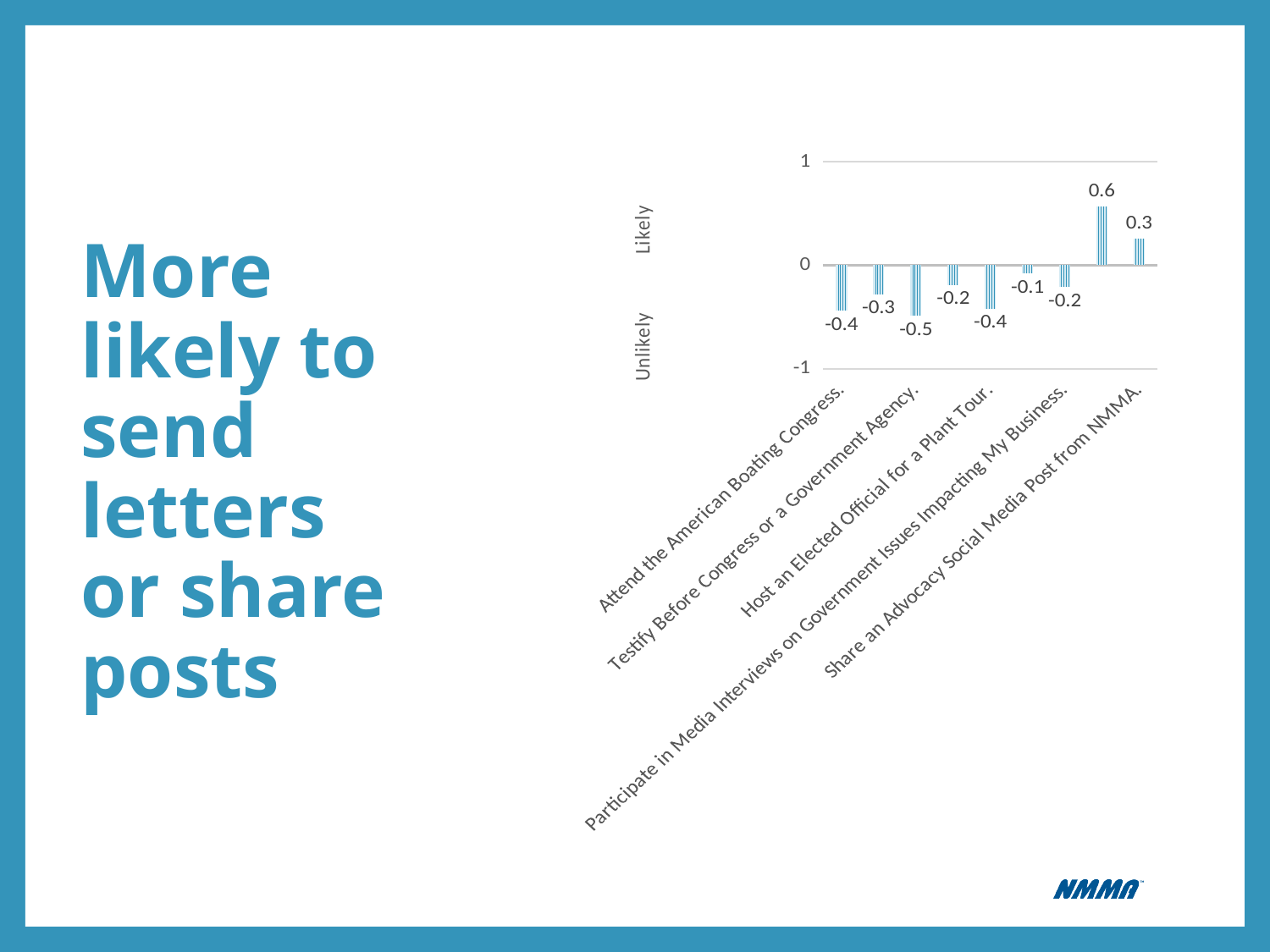
What is the value for "Share an Advocacy Social Media Post from NMMA."? 0.3 What is the highest value shown in the chart? 0.6 What type of chart is shown on the slide? bar chart What two words label the vertical axis of the chart? Likely and Unlikely How many bars are plotted in the chart? 9 What is the difference between the values for "Share an Advocacy Social Media Post from NMMA." and "Attend the American Boating Congress."? 0.7 Which labeled category has the lowest value in the chart? Testify Before Congress or a Government Agency. What is the value for "Host an Elected Official for a Plant Tour."? -0.4 Which has a higher value: "Participate in Media Interviews on Government Issues Impacting My Business." or "Testify Before Congress or a Government Agency."? Participate in Media Interviews on Government Issues Impacting My Business. What is the value for "Attend the American Boating Congress."? -0.4 What is the value for "Testify Before Congress or a Government Agency."? -0.5 How many bars in the chart have a positive value? 2